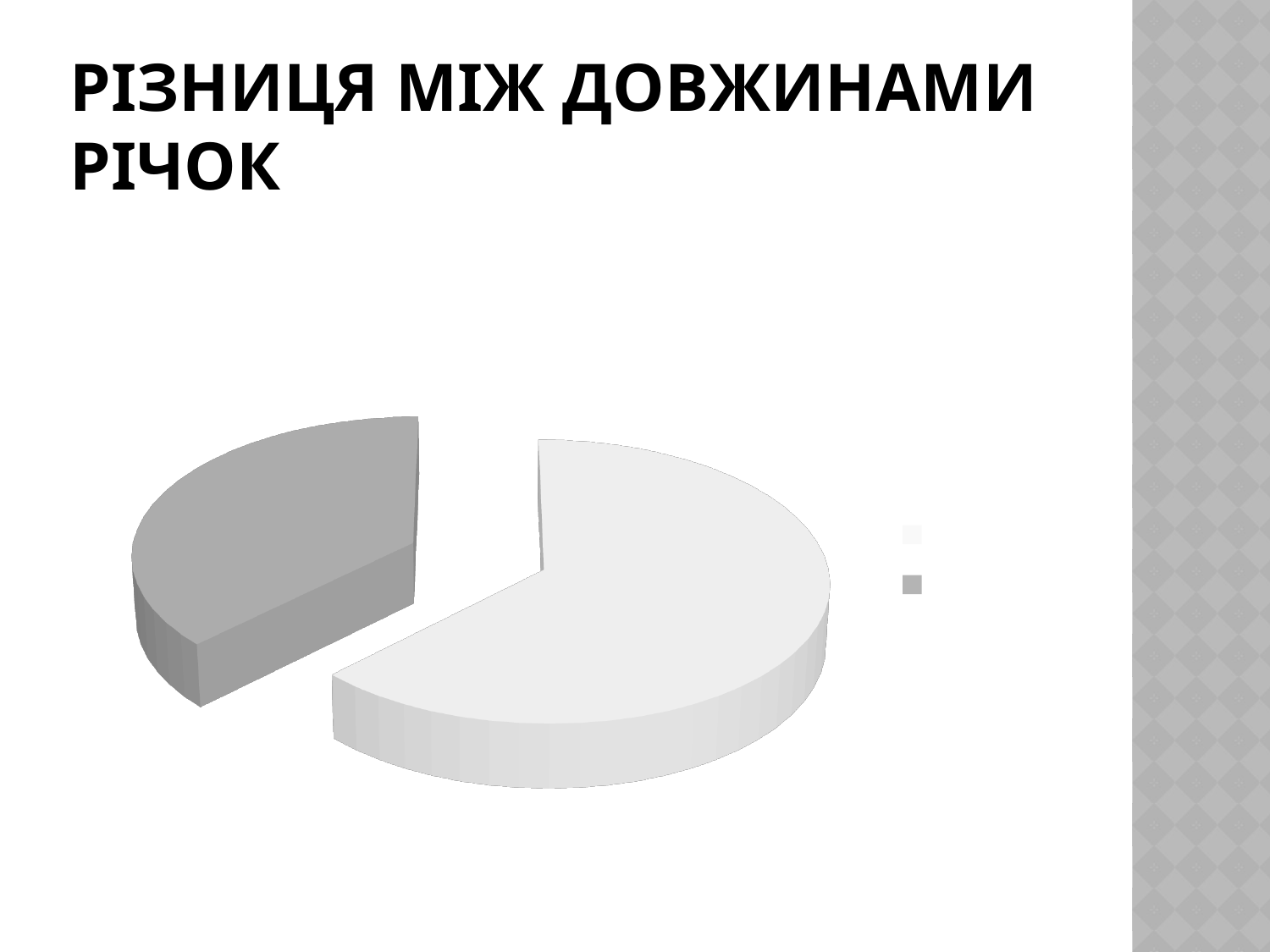
How many slices does the pie chart have? 2 What kind of chart is shown on the slide? pie chart Which slice of the pie chart is the smallest? the dark grey slice Which slice of the pie chart is larger, the light grey one or the dark grey one? the light grey one Is the light grey slice of the pie chart greater or less than half of the pie? greater How many entries does the legend of the pie chart list? 2 What is the title of the slide containing the pie chart? РІЗНИЦЯ МІЖ ДОВЖИНАМИ РІЧОК